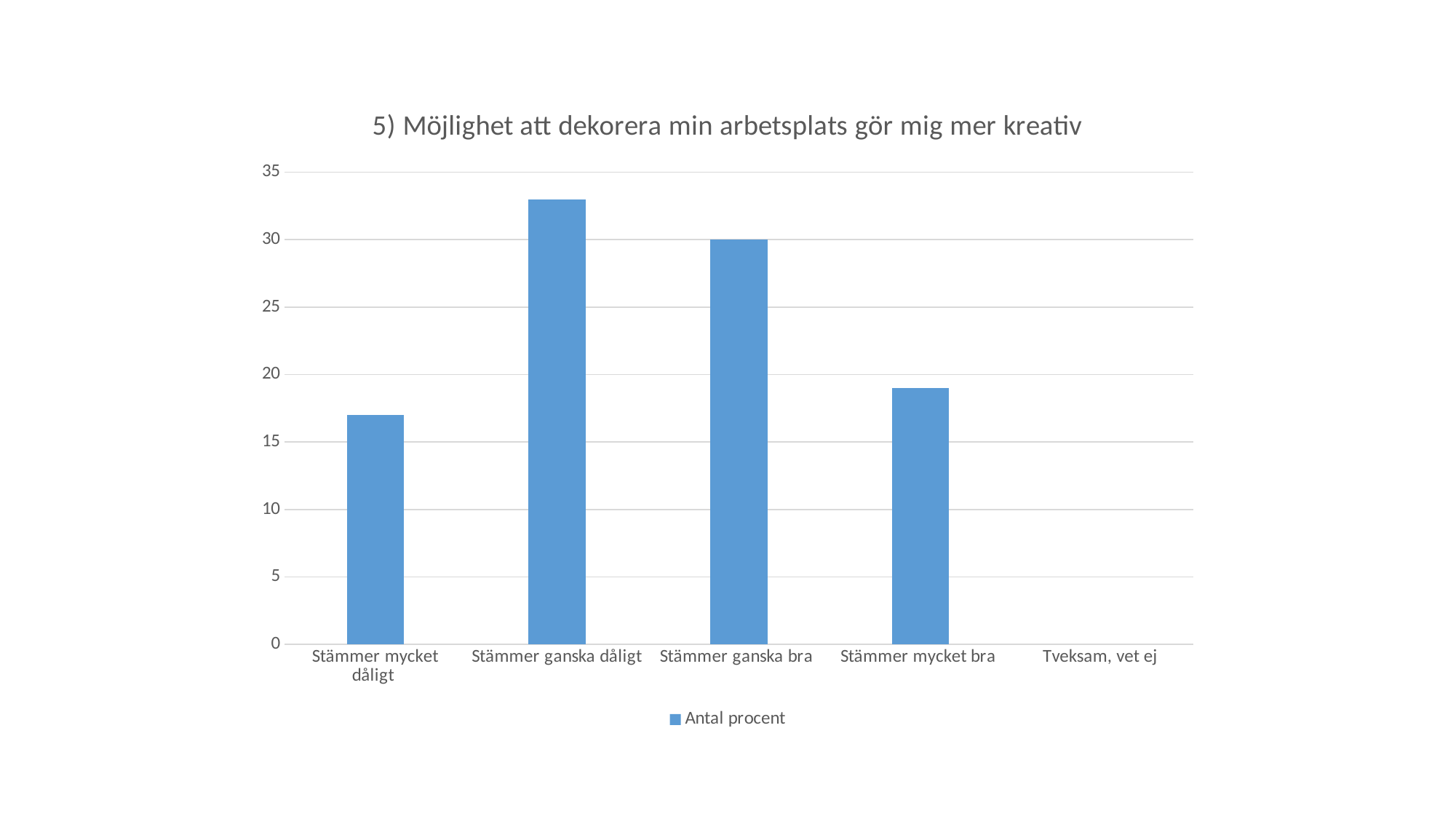
Is the value for Stämmer ganska dåligt greater or less than 30? greater What is the name of the series shown in the legend? Antal procent Which category has the highest value? Stämmer ganska dåligt What kind of chart is shown on the slide? Bar chart What is the value for Stämmer ganska bra? 30 Is the value for Stämmer mycket bra greater or less than 15? greater How many series does the legend list? 1 How many categories are shown on the x axis? 5 Which is larger, the value for Stämmer ganska dåligt or the value for Stämmer mycket bra? Stämmer ganska dåligt Is the value for Stämmer mycket dåligt greater or less than 20? less